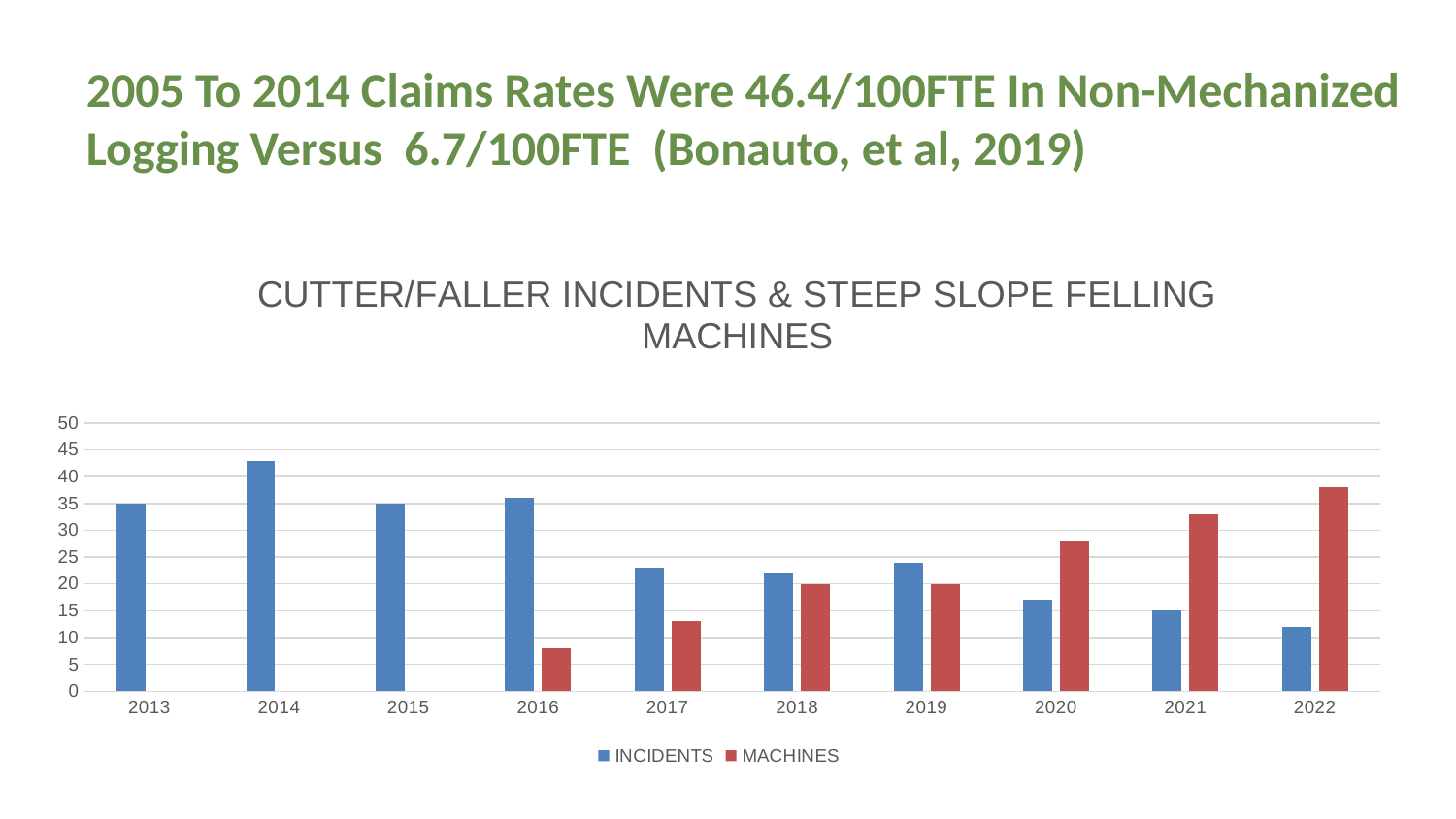
In 2022, which is larger, INCIDENTS or MACHINES? MACHINES What type of chart is shown on the slide? Bar chart Is the MACHINES value for 2021 greater or less than 30? greater Is the INCIDENTS value for 2014 greater or less than 40? greater How many years are shown on the x axis? 10 Which year has the lowest INCIDENTS value? 2022 Which year has the highest INCIDENTS value? 2014 In 2017, which is larger, INCIDENTS or MACHINES? INCIDENTS How many series does the legend list? 2 Which year has the highest MACHINES value? 2022 Is the MACHINES value for 2016 greater or less than 10? less Do the MACHINES values rise or fall from 2016 to 2022? rise